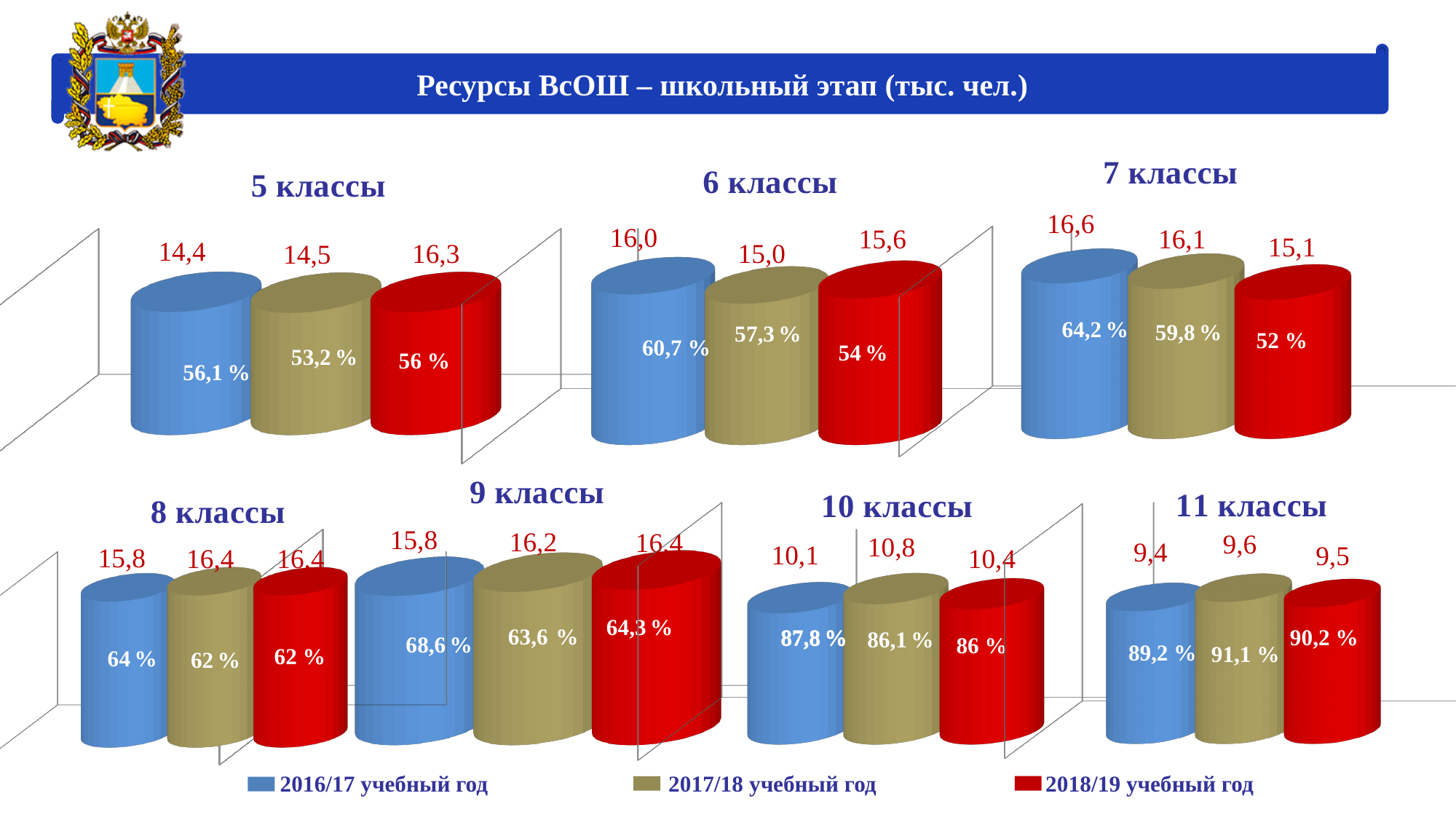
In the '10 классы' chart, which year has the highest value? 2017/18 учебный год What kind of chart is the '6 классы' chart? bar chart In the '8 классы' chart, what percentage is printed on the 2016/17 bar? 64 % In the '5 классы' chart, do the values rise or fall from 2016/17 to 2018/19? rise How many charts are on the slide? 7 In the '5 классы' chart, what is the value for 2018/19 учебный год? 16,3 In the '7 классы' chart, what percentage is printed on the 2018/19 bar? 52 % In the '11 классы' chart, what is the difference between the 2017/18 and 2016/17 values? 0,2 In the '7 классы' chart, which year has the lowest value? 2018/19 учебный год How many series does the legend list? 3 In the '9 классы' chart, which is larger: the value for 2016/17 or for 2018/19? 2018/19 In the '6 классы' chart, what is the value for 2016/17 учебный год? 16,0